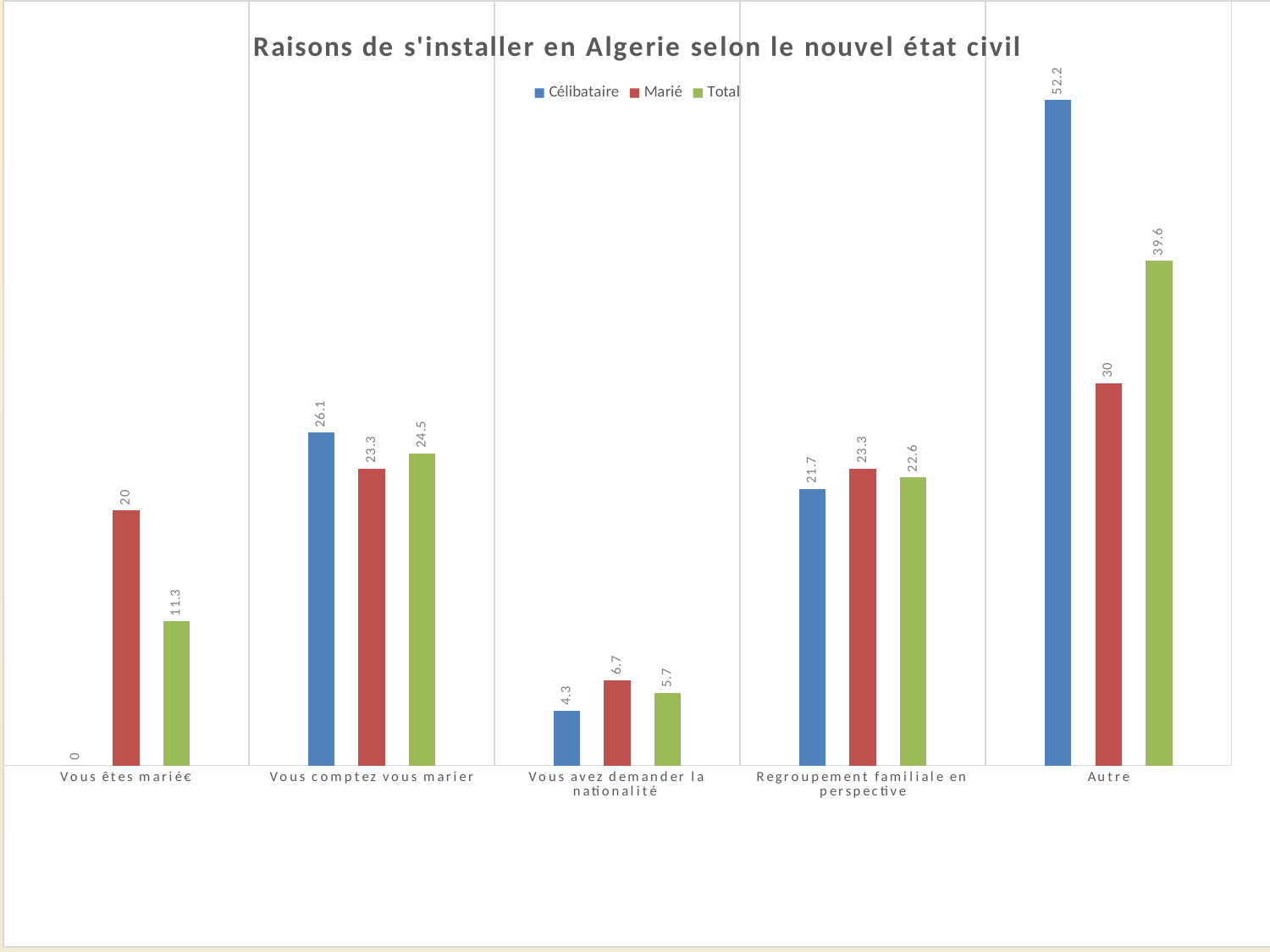
Which category has the lowest Marié value? Vous avez demander la nationalité What is the value for Célibataire in 'Vous avez demander la nationalité'? 4.3 How many categories are shown on the x axis? 5 What is the value for Marié in the 'Vous êtes marié' category? 20 How many series does the legend list? 3 What kind of chart is shown on the slide? Bar chart Which category has the highest Total value? Autre What is the value for Célibataire in the 'Autre' category? 52.2 Which is larger in 'Regroupement familiale en perspective': the Célibataire value or the Marié value? Marié What is the title of the chart? Raisons de s'installer en Algerie selon le nouvel état civil What is the Total value for 'Vous comptez vous marier'? 24.5 What is the difference between the Célibataire and Marié values in the 'Autre' category? 22.2